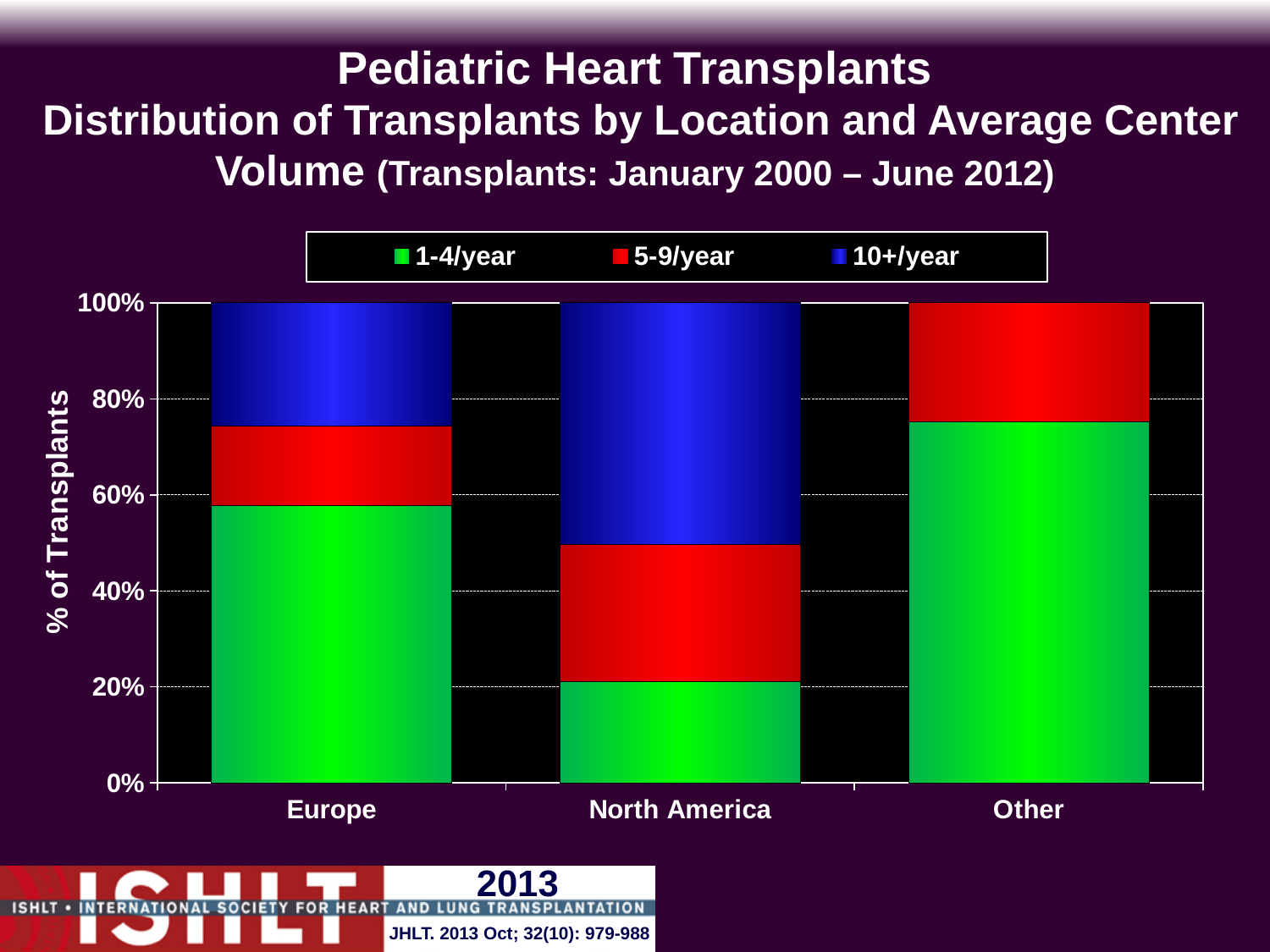
Which location has the smallest 1-4/year segment? North America Which location has the largest 10+/year segment? North America How many locations are shown along the x axis? 3 Is the 1-4/year share for North America greater or less than 40%? less What is the total height of each stacked bar on the y axis? 100% Which location has the largest 1-4/year segment? Other Which is larger: the 10+/year segment for Europe or for North America? North America Is the 1-4/year share for Europe greater or less than 40%? greater Which colour represents the 5-9/year series in the legend? Red What kind of chart is shown on the slide? Stacked bar chart How many series does the legend list? 3 Is the 1-4/year share for Other greater or less than 60%? greater